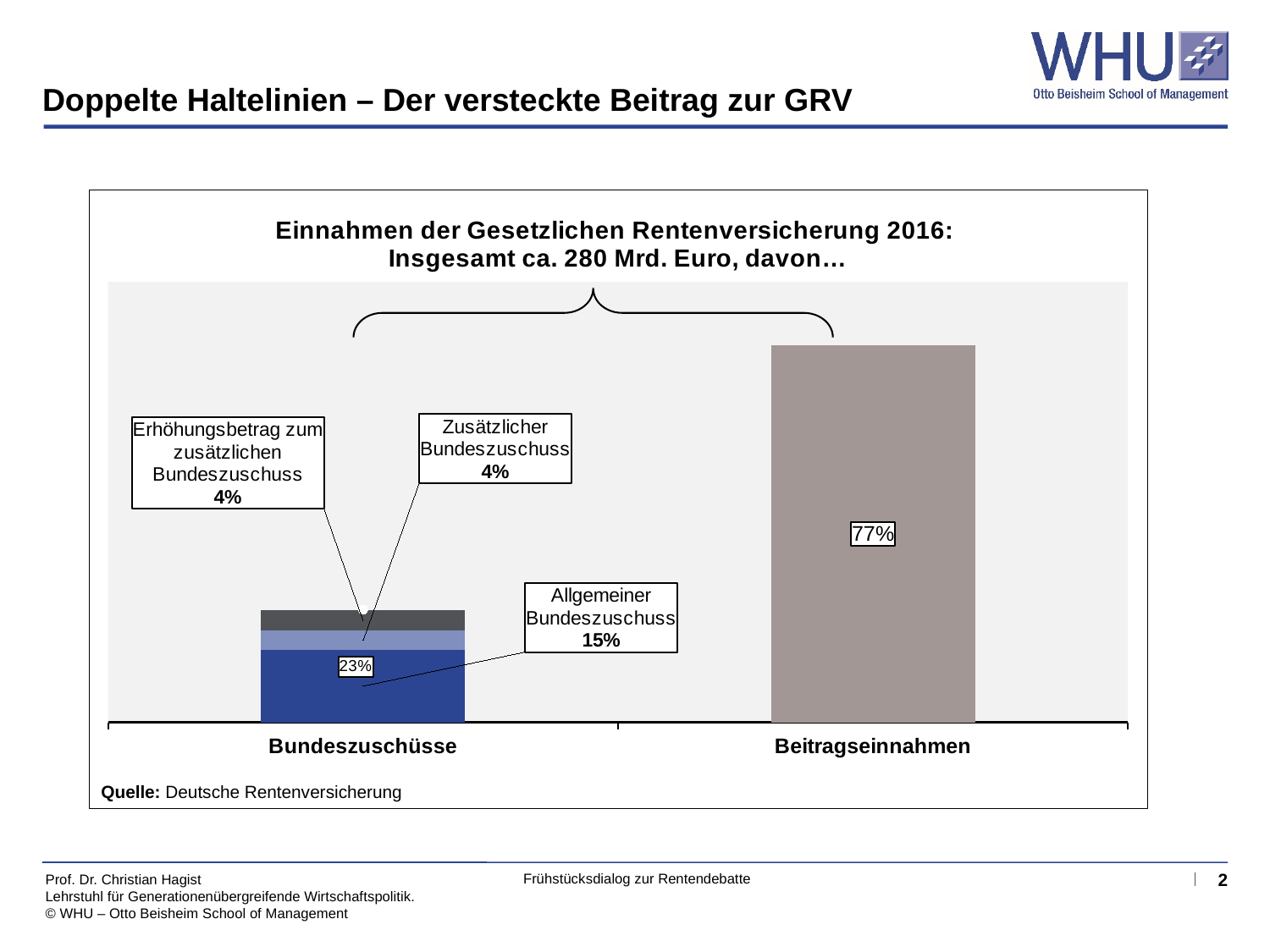
What share does the Allgemeiner Bundeszuschuss account for? 15% What is the value shown for Beitragseinnahmen? 77% According to the chart title, what were the total revenues of the Gesetzliche Rentenversicherung in 2016? ca. 280 Mrd. Euro How many segments make up the Bundeszuschüsse bar? 3 What is the total value shown for the Bundeszuschüsse bar? 23% What is the difference between the Allgemeiner Bundeszuschuss and the Zusätzlicher Bundeszuschuss? 11% How many categories are shown on the x axis? 2 Which category has the higher value, Bundeszuschüsse or Beitragseinnahmen? Beitragseinnahmen What share does the Erhöhungsbetrag zum zusätzlichen Bundeszuschuss account for? 4% What kind of chart is shown on the slide? Bar chart What is the difference between the value for Beitragseinnahmen and the total for Bundeszuschüsse? 54% What share does the Zusätzlicher Bundeszuschuss account for? 4%